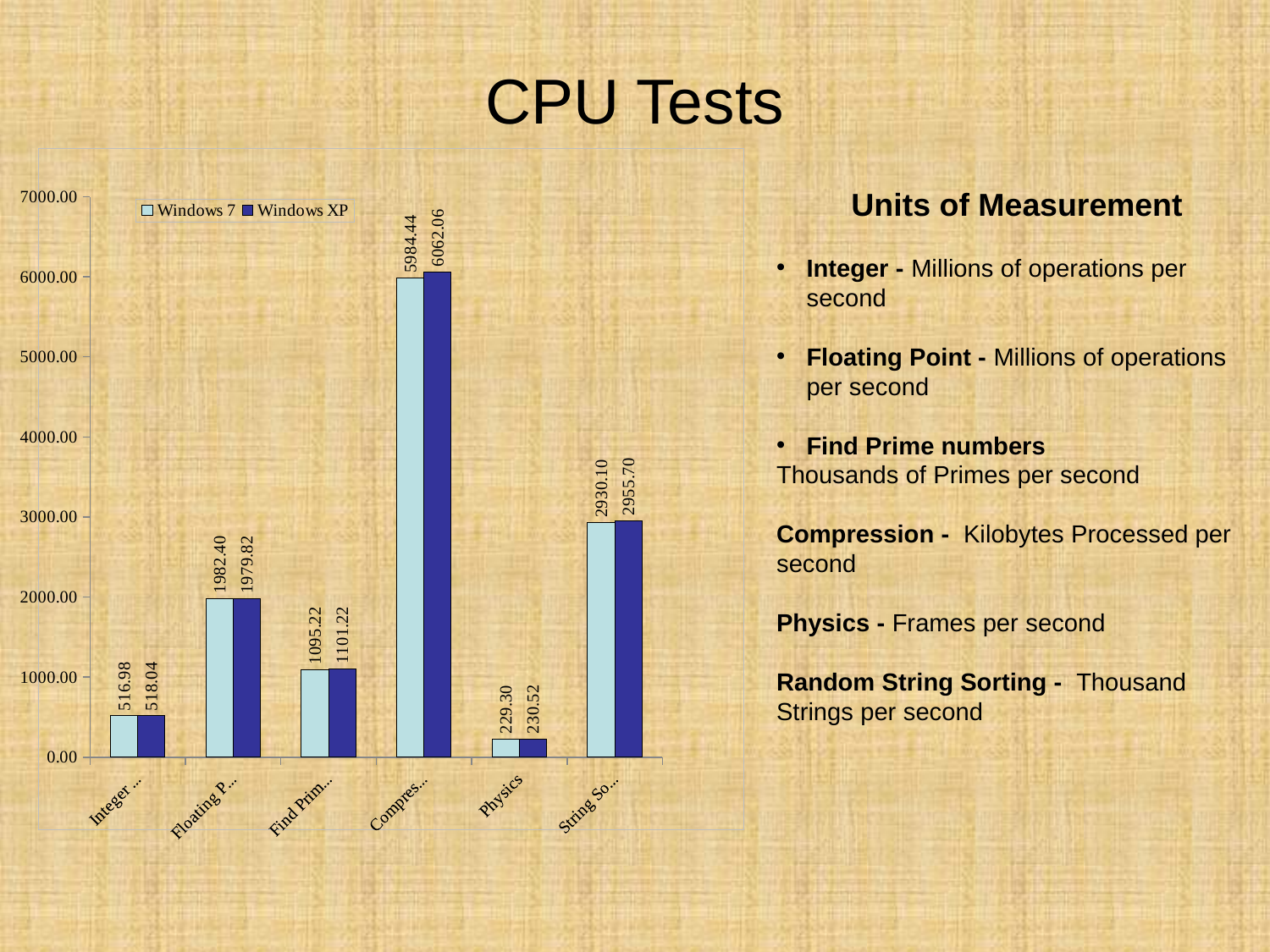
What is the Windows 7 value for the Physics test? 229.30 How many categories are plotted on the x axis? 6 Which series is shown in light blue in the legend? Windows 7 What is the Windows XP value for the Compression test? 6062.06 What is the difference between the Windows XP and Windows 7 values for the Compression test? 77.62 What is the Windows 7 value for the Floating Point test? 1982.40 For the String Sorting test, which is larger: the Windows 7 value or the Windows XP value? Windows XP Which test has the lowest Windows 7 value? Physics How many series does the legend list? 2 What is the Windows XP value for the Integer test? 518.04 Which test has the highest Windows XP value? Compression What type of chart is shown on the slide? bar chart